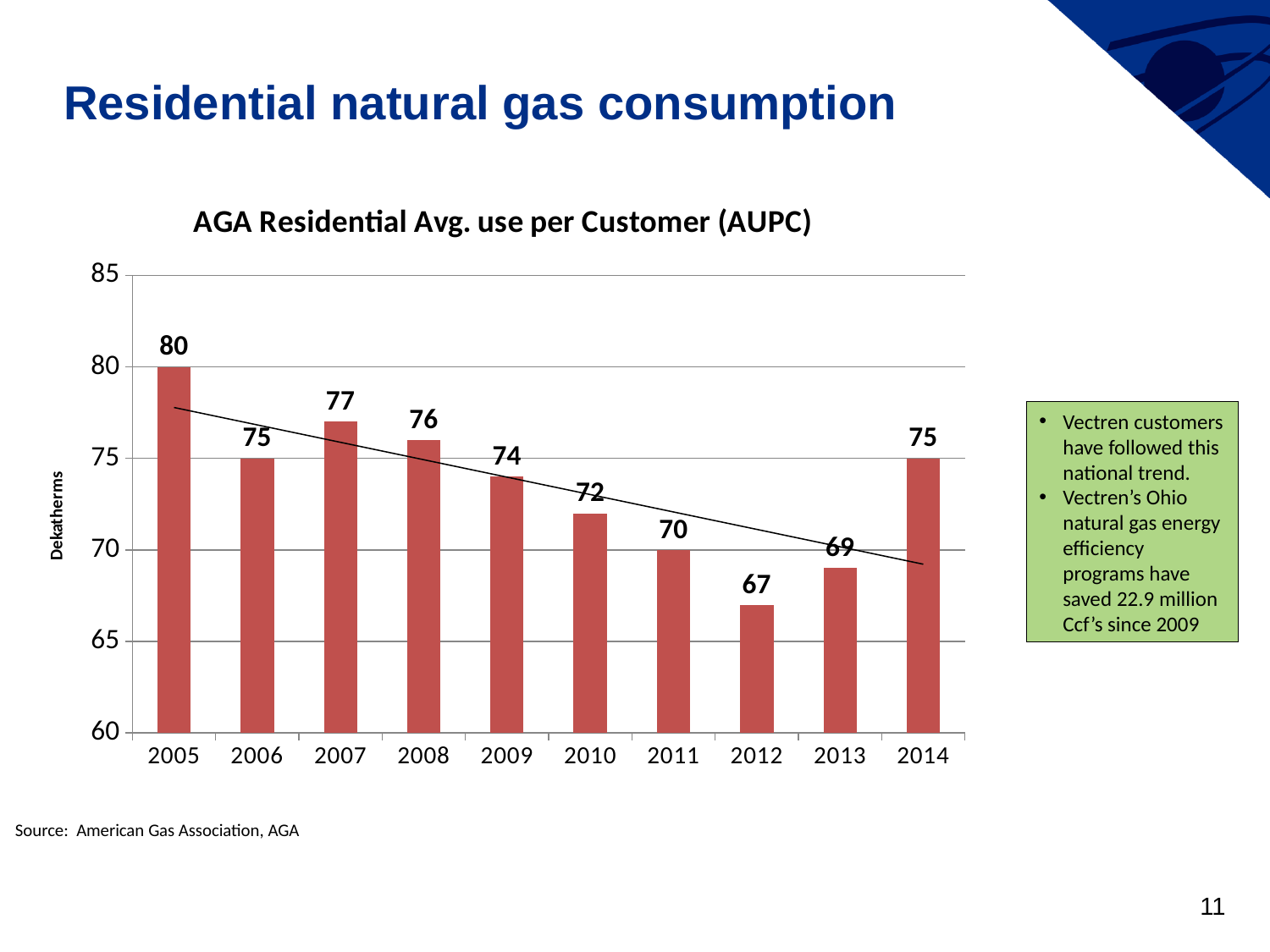
Which year has the highest value? 2005 Which year has the lowest value? 2012 Which is larger, the value for 2007 or the value for 2011? 2007 What is the difference between the values for 2005 and 2012? 13 Do the values generally rise or fall from 2005 to 2013? fall What is the value for 2005? 80 What is the value for 2012? 67 What kind of chart is this? bar chart How many years are shown on the x axis? 10 Is the value for 2013 greater or less than 70? less What is the title of the chart? AGA Residential Avg. use per Customer (AUPC) What is the value for 2010? 72